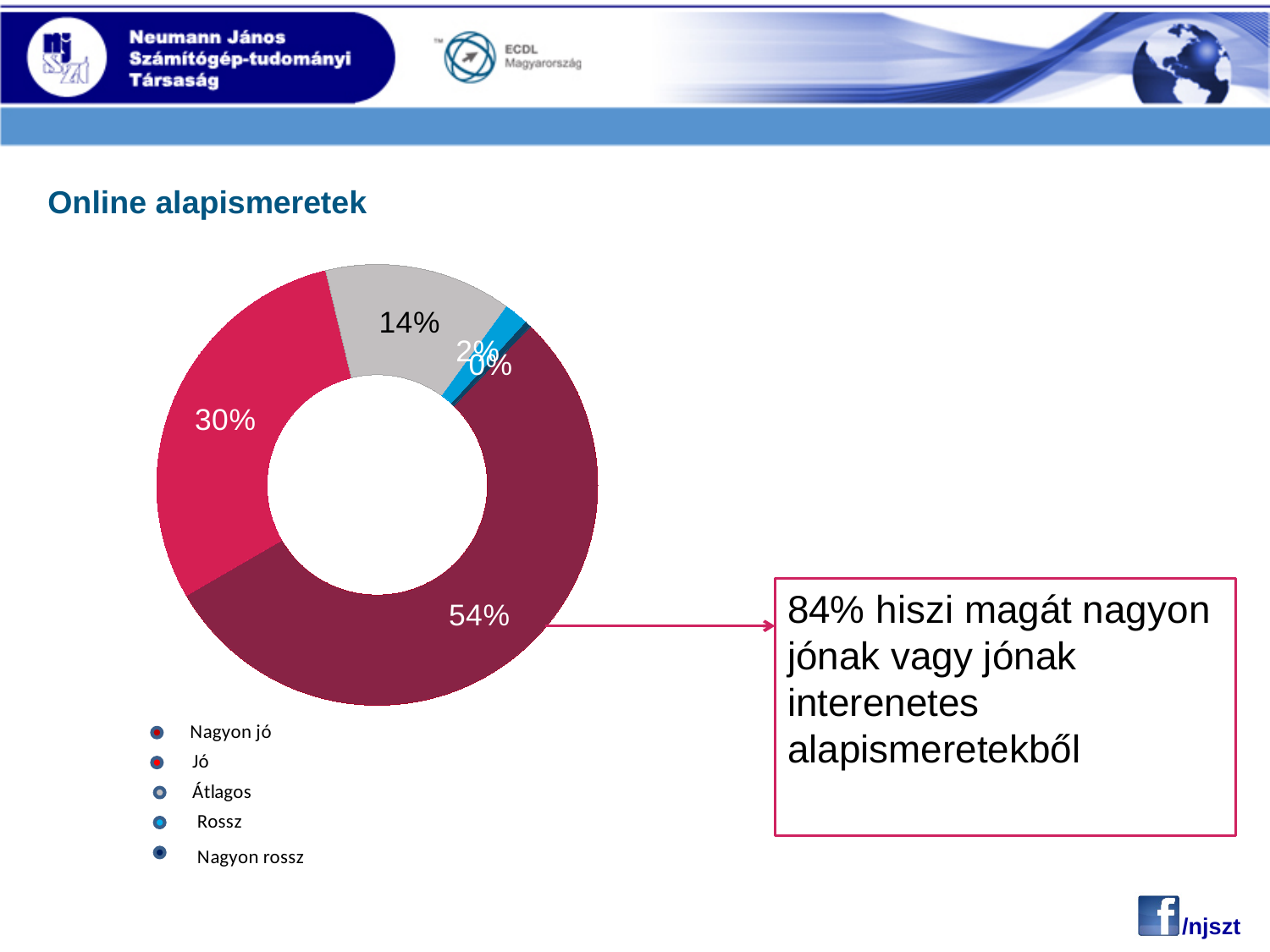
Which category has the largest share of the chart? Nagyon jó What value is shown for the "Átlagos" slice? 14% What percentage of the doughnut chart is labelled for the "Nagyon jó" category? 54% What percentage is shown for the "Nagyon rossz" category? 0% What percentage does the "Jó" slice show? 30% Which is larger, the "Jó" share or the "Átlagos" share? Jó Which category has the smallest share of the chart? Nagyon rossz What kind of chart is shown on the slide? Doughnut (pie) chart What is the combined share of the "Nagyon jó" and "Jó" slices? 84% How many categories does the chart's legend list? 5 What percentage is shown for the "Rossz" category? 2% How many percentage points larger is the "Nagyon jó" share than the "Jó" share? 24 percentage points